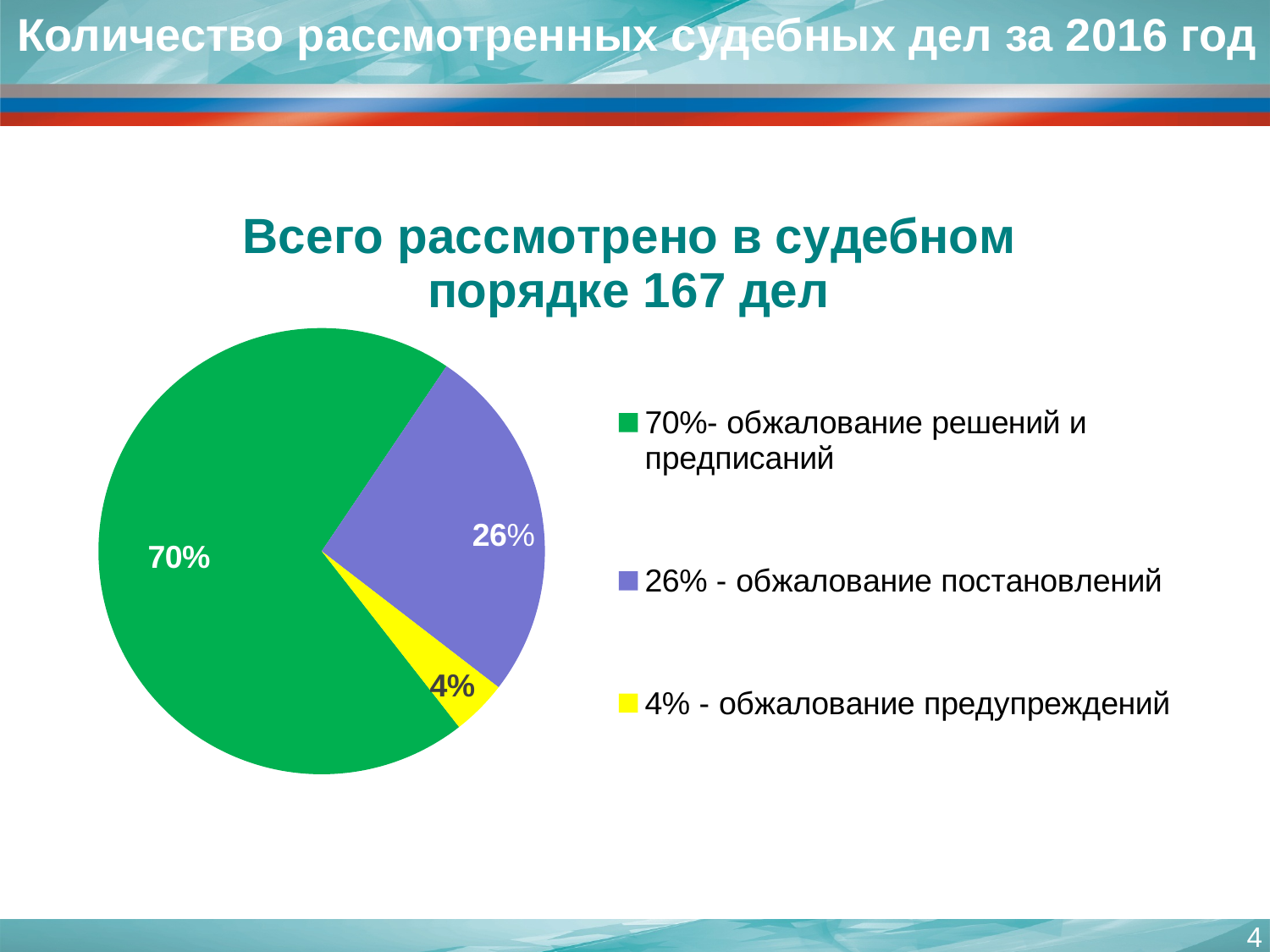
What kind of chart is shown on the slide? pie chart What colour is the slice for обжалование предупреждений? yellow Which category has the largest slice of the pie? обжалование решений и предписаний Which is larger: the slice for обжалование постановлений or the slice for обжалование предупреждений? обжалование постановлений What share of the pie is labelled for обжалование предупреждений? 4% What share of the pie is labelled for обжалование решений и предписаний? 70% Which category has the smallest slice of the pie? обжалование предупреждений What share of the pie is labelled for обжалование постановлений? 26% How many slices does the pie chart have? 3 According to the chart title, how many cases in total were considered in court? 167 What is the difference in percentage points between the slice for обжалование решений и предписаний and the slice for обжалование постановлений? 44 How many entries does the legend list? 3